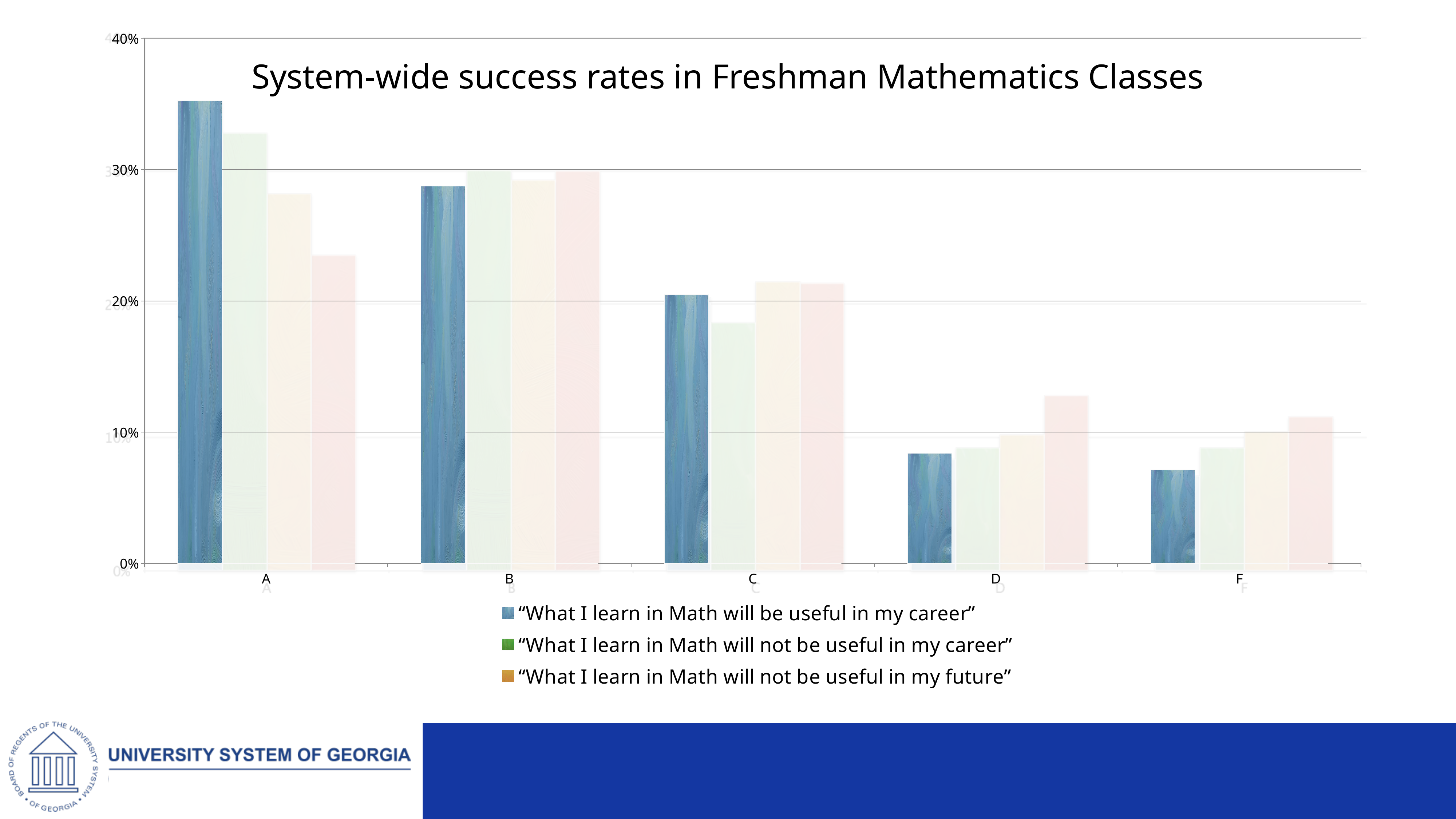
Is the value for B in the series "What I learn in Math will be useful in my career" greater or less than 30%? less Do the values for "What I learn in Math will be useful in my career" rise or fall from A to F? fall How many categories are shown on the x axis? 5 Is the value for A in the series "What I learn in Math will be useful in my career" greater or less than 30%? greater What kind of chart is shown on the slide? bar chart In the series "What I learn in Math will be useful in my career", which is larger, the value for A or the value for B? A Is the value for D in the series "What I learn in Math will be useful in my career" greater or less than 10%? less For the series "What I learn in Math will be useful in my career", which category has the highest value? A How many series does the legend list? 3 For the series "What I learn in Math will be useful in my career", which category has the lowest value? F What is the first entry listed in the legend? "What I learn in Math will be useful in my career" What is the title of the chart? System-wide success rates in Freshman Mathematics Classes